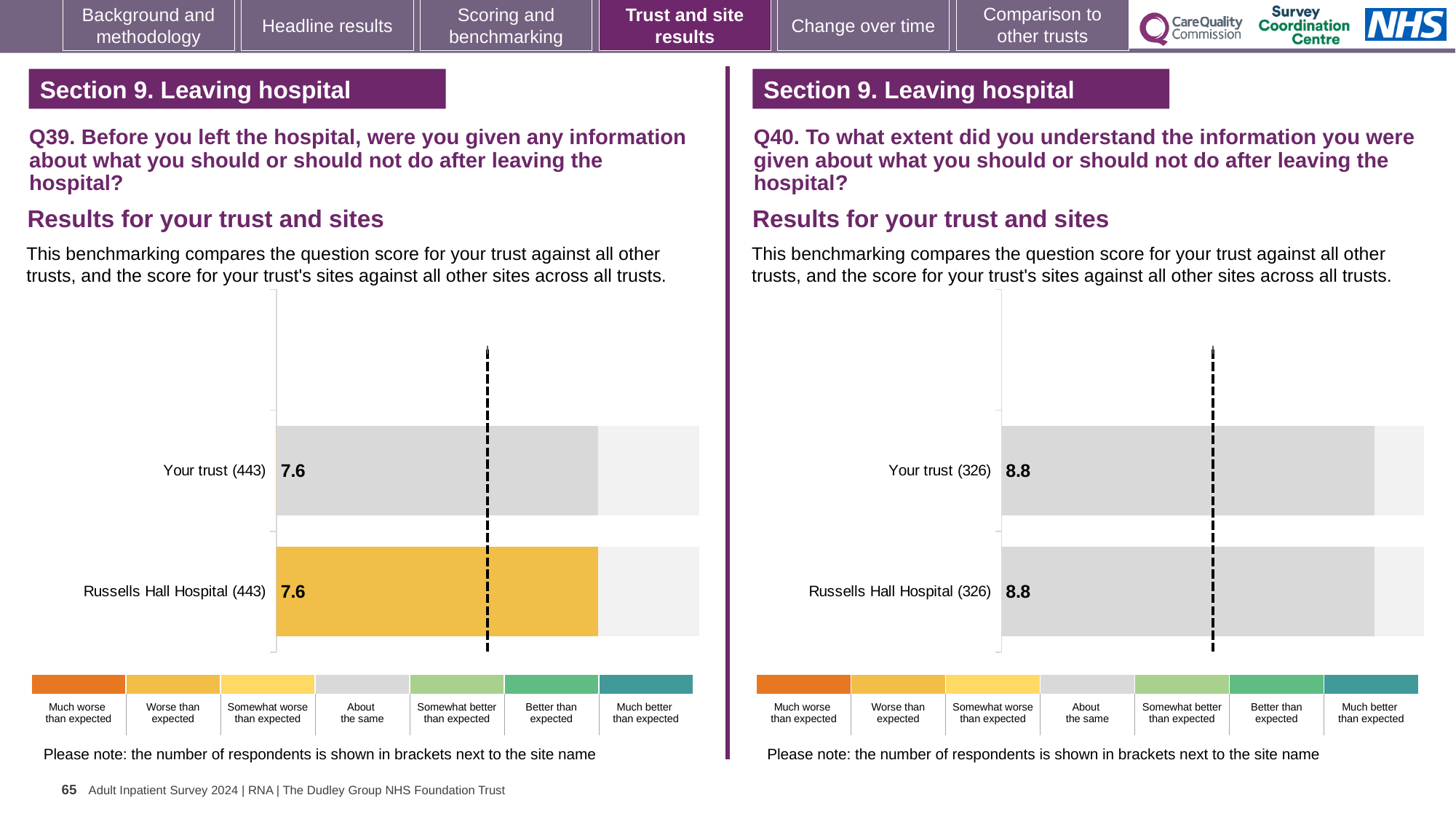
What kind of chart is used on the Q40 chart (right)? Bar chart On the Q40 chart (right), what is the score for Your trust? 8.8 Which section heading appears above both charts on the slide? Section 9. Leaving hospital On the Q39 chart (left), what is the score for Your trust? 7.6 How many bars are plotted on the Q39 chart (left)? 2 On the Q40 chart (right), how many respondents are shown in brackets for Your trust? 326 On the Q39 chart (left), what is the difference between the score for Your trust and the score for Russells Hall Hospital? 0 On the Q39 chart (left), what colour is the bar for Russells Hall Hospital? Yellow/orange On the Q39 chart (left), what is the score for Russells Hall Hospital? 7.6 On the Q39 chart (left), how many respondents are shown in brackets for Russells Hall Hospital? 443 On the Q40 chart (right), what is the score for Russells Hall Hospital? 8.8 How many categories does the colour key below the Q40 chart (right) list? 7